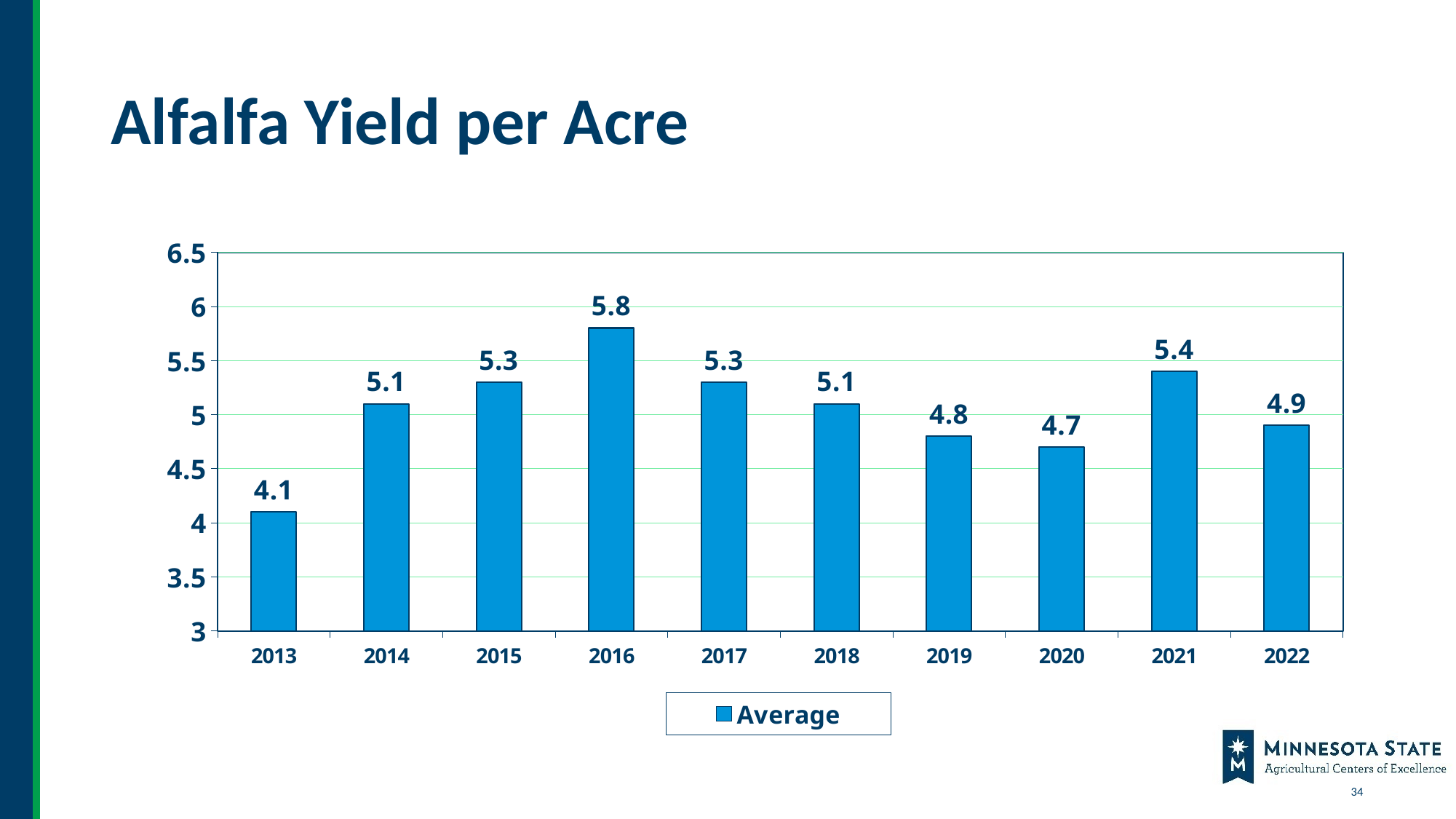
What is the difference between the 2016 and 2013 average alfalfa yields per acre? 1.7 What is the average alfalfa yield per acre for 2016? 5.8 Which year has the lowest average alfalfa yield per acre? 2013 What kind of chart is shown on the slide? bar chart Which year has the highest average alfalfa yield per acre? 2016 What is the average alfalfa yield per acre for 2020? 4.7 What is the average alfalfa yield per acre for 2013? 4.1 Which year has a higher average alfalfa yield per acre, 2021 or 2022? 2021 Is the value for 2019 greater or less than 5? less How many years are shown on the x axis of the chart? 10 What is the title of the slide? Alfalfa Yield per Acre How many series does the legend list? 1